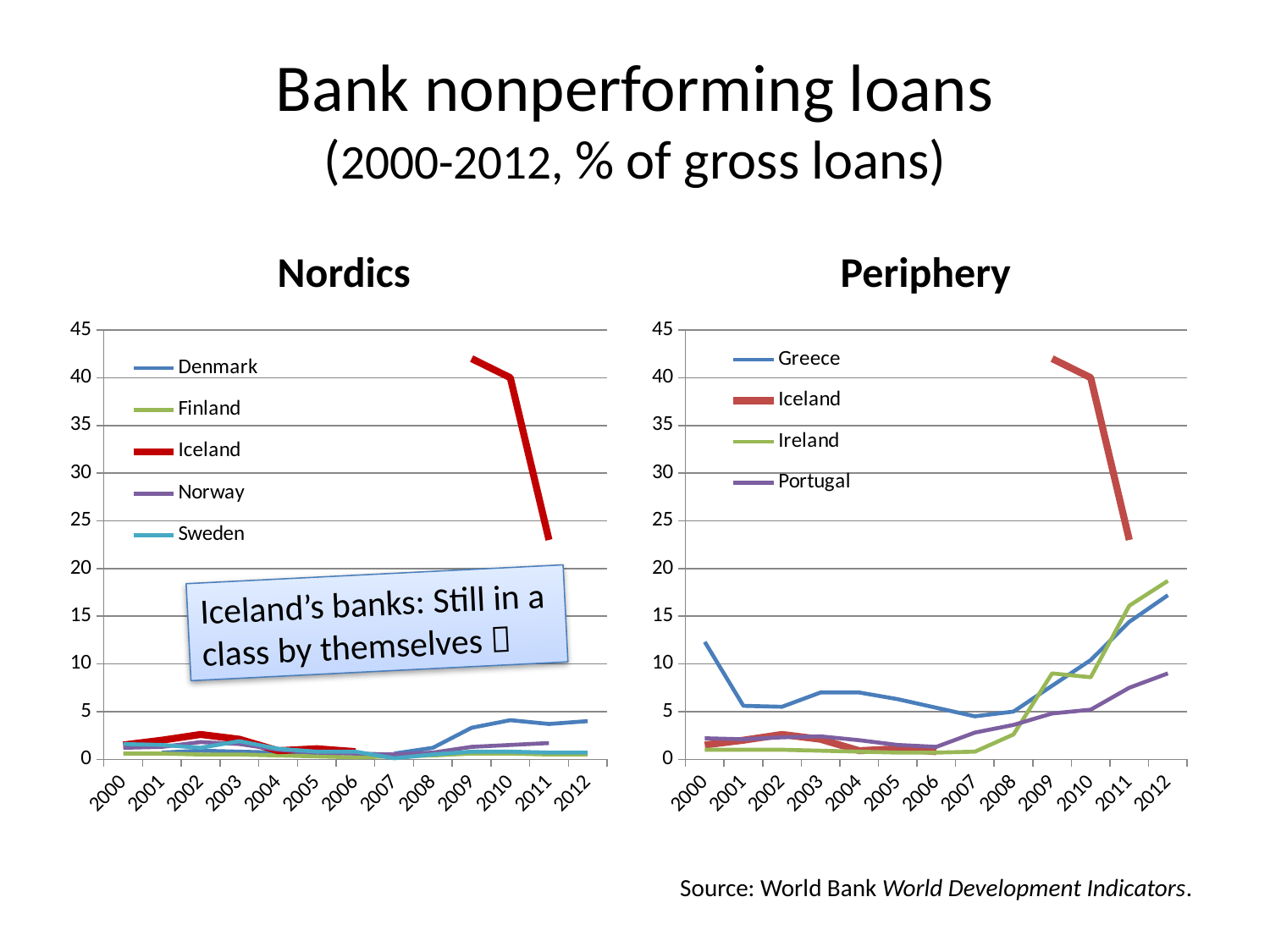
What kind of chart is the Nordics chart? line chart How many series does the legend of the Periphery chart list? 4 In the Nordics chart, is the value for Iceland in 2009 greater or less than 40? greater In the Periphery chart, is the value for Iceland in 2011 greater or less than 25? less Which country appears in the legends of both the Nordics and Periphery charts? Iceland How many years are shown on the x axis of the Periphery chart? 13 In the Nordics chart, which country has the highest value in 2009? Iceland How many series does the legend of the Nordics chart list? 5 In the Periphery chart, does the value for Ireland rise or fall from 2007 to 2012? rise In the Periphery chart, which is larger in 2012, Ireland or Portugal? Ireland In the Periphery chart, is the value for Greece in 2000 greater or less than 10? greater In the Periphery chart, does the value for Greece rise or fall from 2000 to 2001? fall